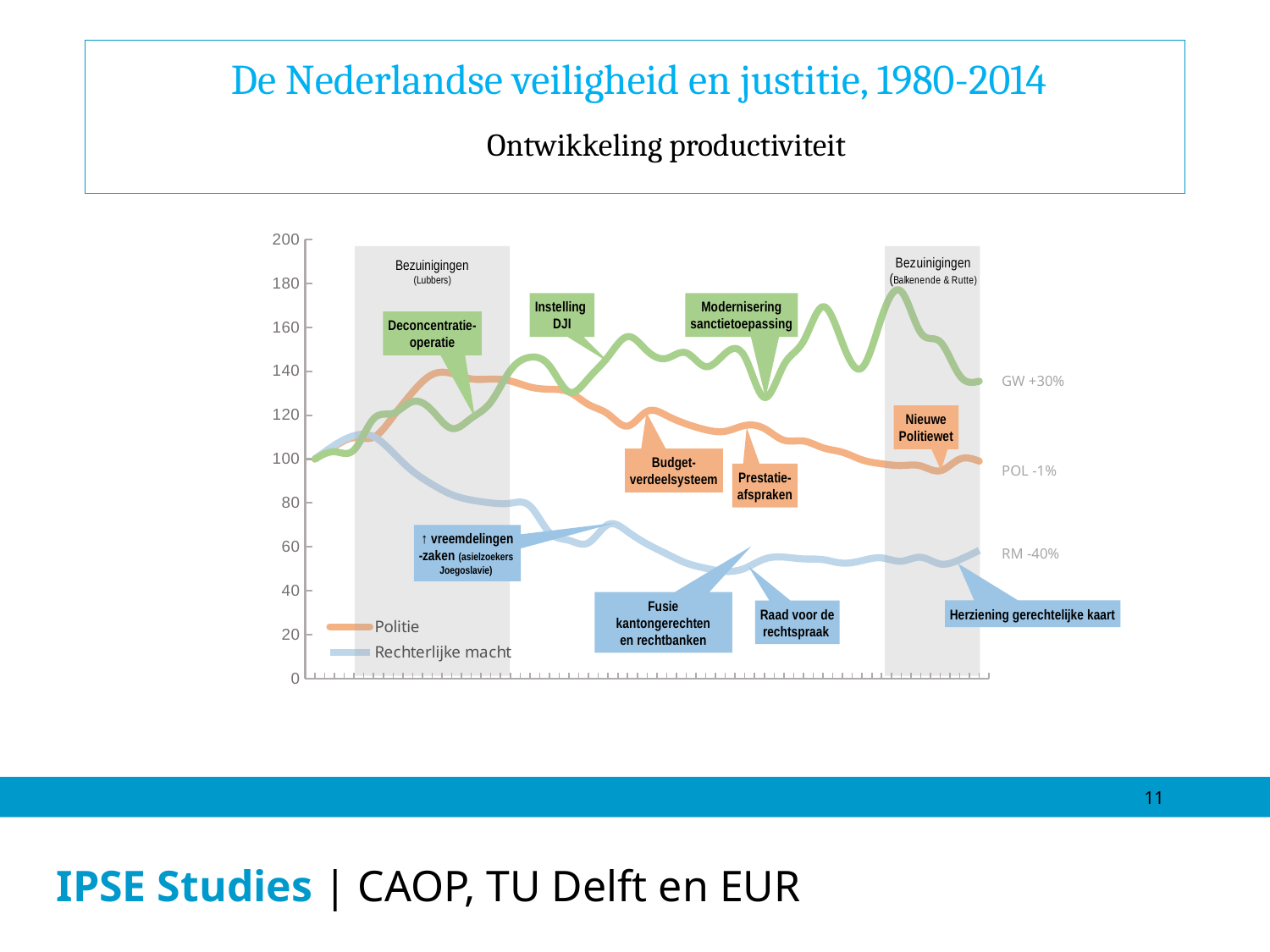
What kind of chart is shown on the slide? line chart What percentage change is printed at the right end of the green line (GW)? +30% Is the highest peak of the green (GW) line greater or less than 160? greater What is the subtitle of the chart on the slide? Ontwikkeling productiviteit What percentage change is printed at the right end for POL? -1% At the right end of the chart, which line is higher: the green (GW) line or the Politie line? the green (GW) line What percentage change is printed at the right end for RM? -40% Is the value of the Rechterlijke macht line at the right end of the chart greater or less than 80? less Which series does the orange line represent according to the legend? Politie Does the green (GW) line overall rise or fall along the x axis? rise How many series does the legend list? 2 Does the Rechterlijke macht line overall rise or fall along the x axis? fall